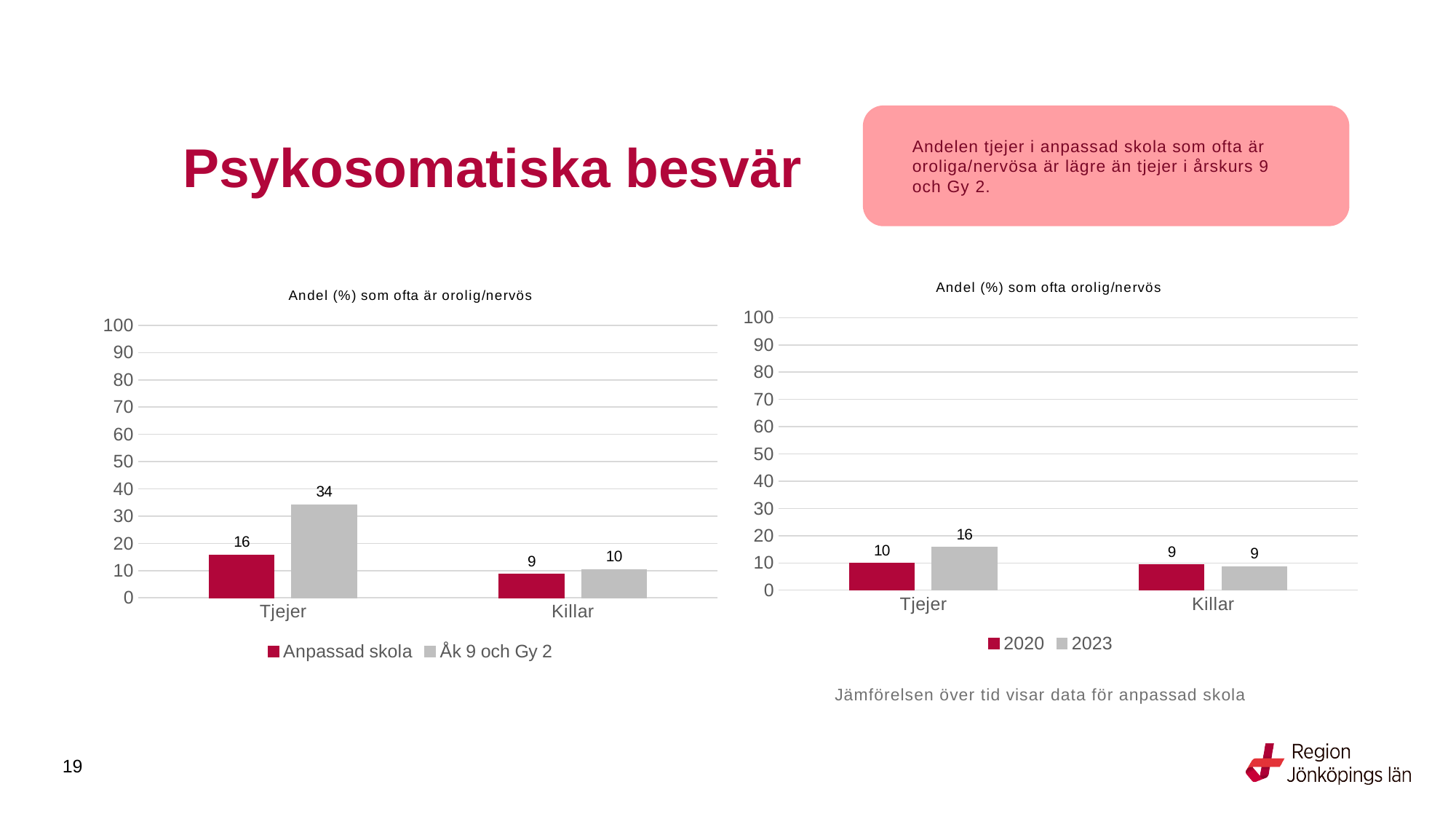
In the right chart, what are the two series listed in the legend? 2020 and 2023 In the right chart, what is the value for Tjejer in 2023? 16 What kind of chart is the left chart? Bar chart In the right chart, what is the value for Killar in 2020? 9 In the left chart, what is the value for Killar in the Anpassad skola series? 9 In the left chart, how many series does the legend list? 2 In the right chart, what is the difference between the 2023 and 2020 values for Tjejer? 6 In the right chart, which is larger for Tjejer: the 2020 value or the 2023 value? 2023 In the right chart, how many categories are shown on the x axis? 2 In the left chart, what is the value for Tjejer in the Åk 9 och Gy 2 series? 34 In the left chart, which category has the highest value in the Åk 9 och Gy 2 series? Tjejer In the left chart, what is the difference between the Åk 9 och Gy 2 and Anpassad skola values for Tjejer? 18